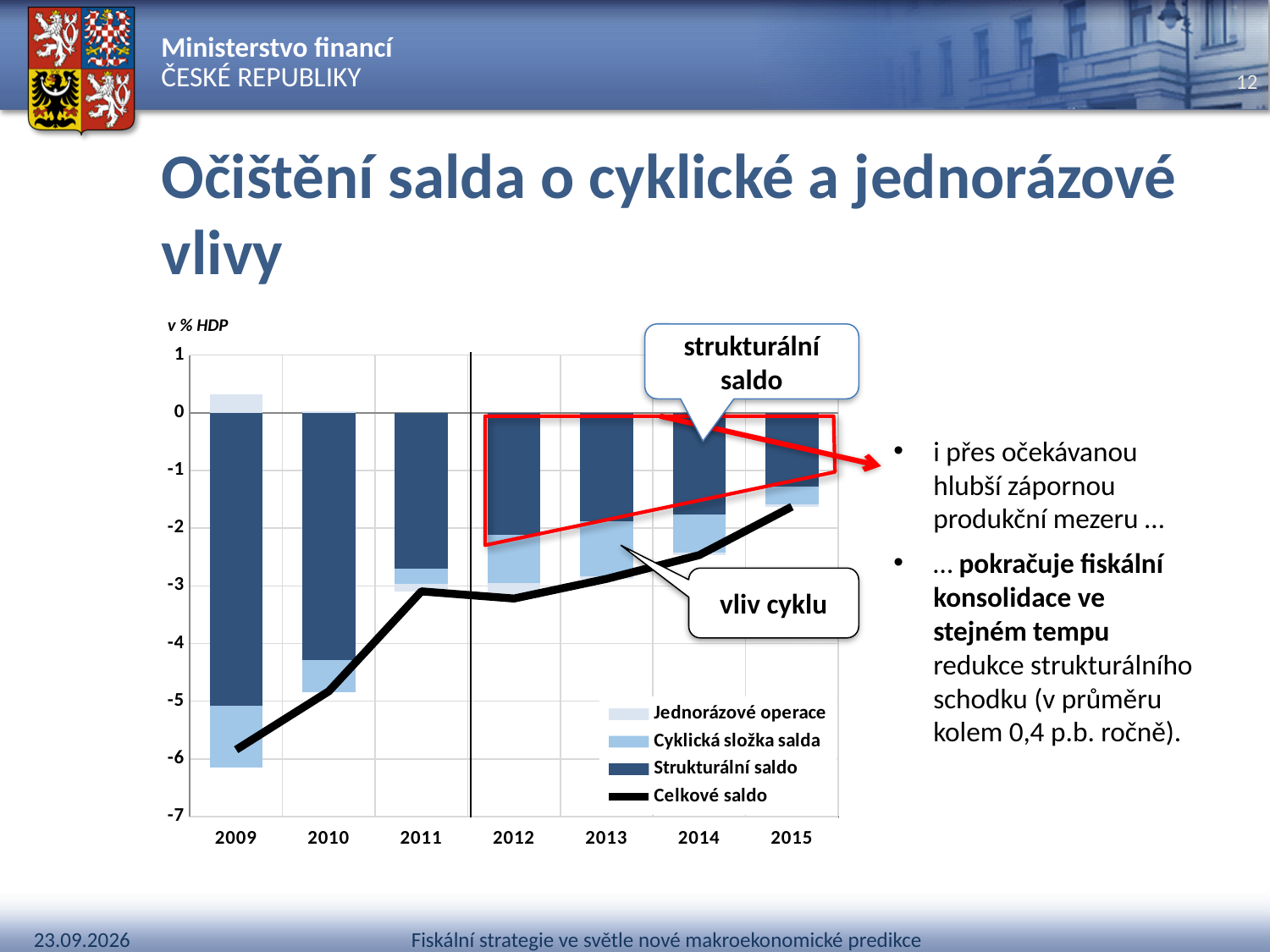
In which year is the Celkové saldo line at its highest value? 2015 What kind of chart is shown on the slide? bar chart with a line How many series does the chart legend list? 4 Does the Celkové saldo line rise or fall from 2009 to 2015? rise Is the Celkové saldo value for 2015 above or below -2 on the axis? above Which legend entry is drawn as a black line in the chart? Celkové saldo In which year is the Celkové saldo line at its lowest value? 2009 Which is higher, the Celkové saldo value for 2010 or for 2011? 2011 Is the Celkové saldo value for 2009 above or below -5 on the axis? below How many years are shown on the x axis of the chart? 7 Is the Strukturální saldo bar for 2012 above or below -3 on the axis? above What unit is indicated above the chart's y axis? v % HDP